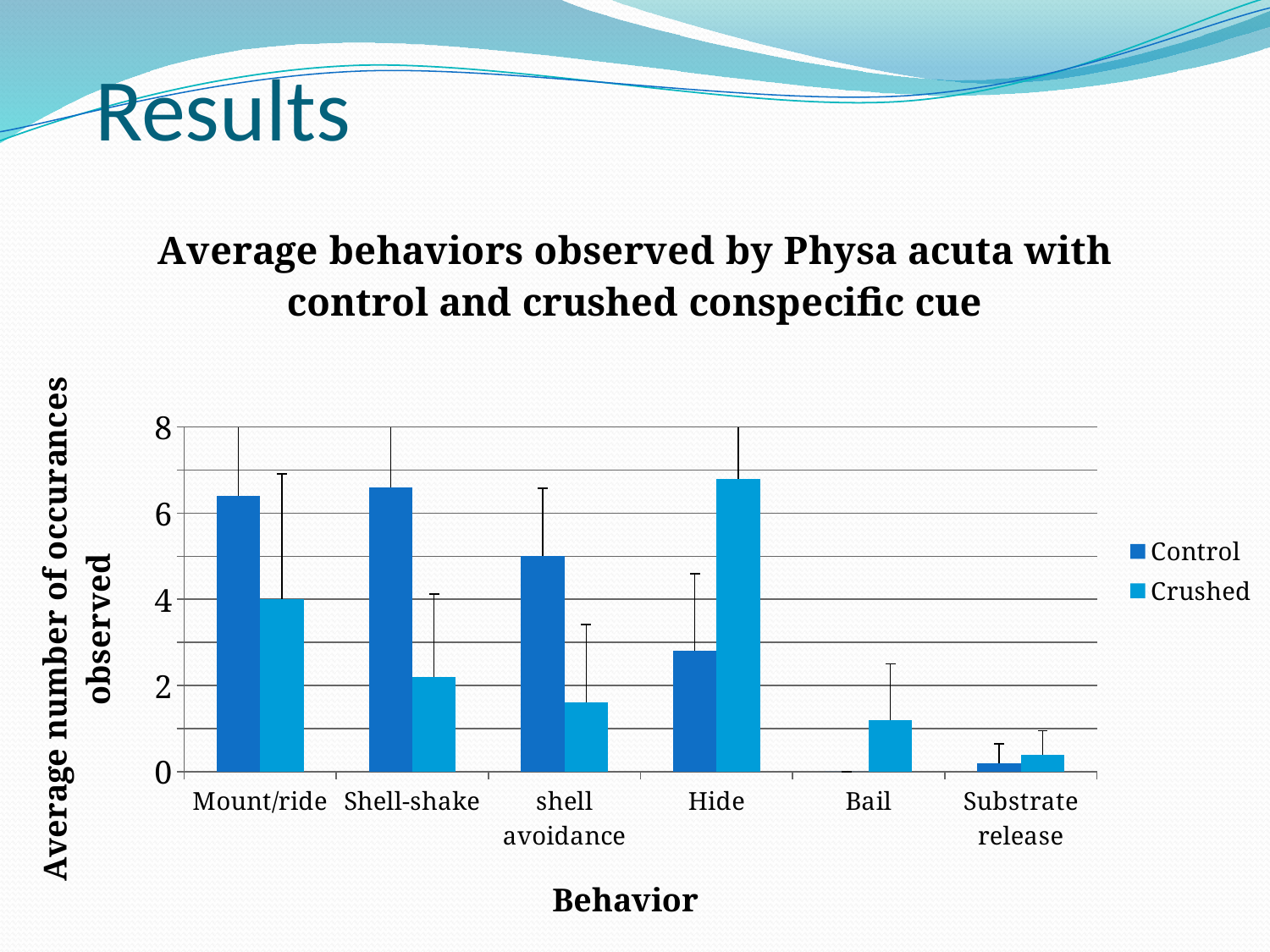
Is the Crushed value for shell avoidance greater or less than 2? less How many behavior categories are shown on the x axis? 6 For Mount/ride, which is larger: the Control value or the Crushed value? Control Is the Crushed value for Hide greater or less than 6? greater How many series does the legend list? 2 For Hide, which is larger: the Control value or the Crushed value? Crushed Is the Control value for Shell-shake greater or less than 6? greater What is the title of the x axis? Behavior For the Control series, which behavior has the lowest average number of occurrences? Bail What kind of chart is shown on the slide? bar chart For the Crushed series, which behavior has the highest average number of occurrences? Hide